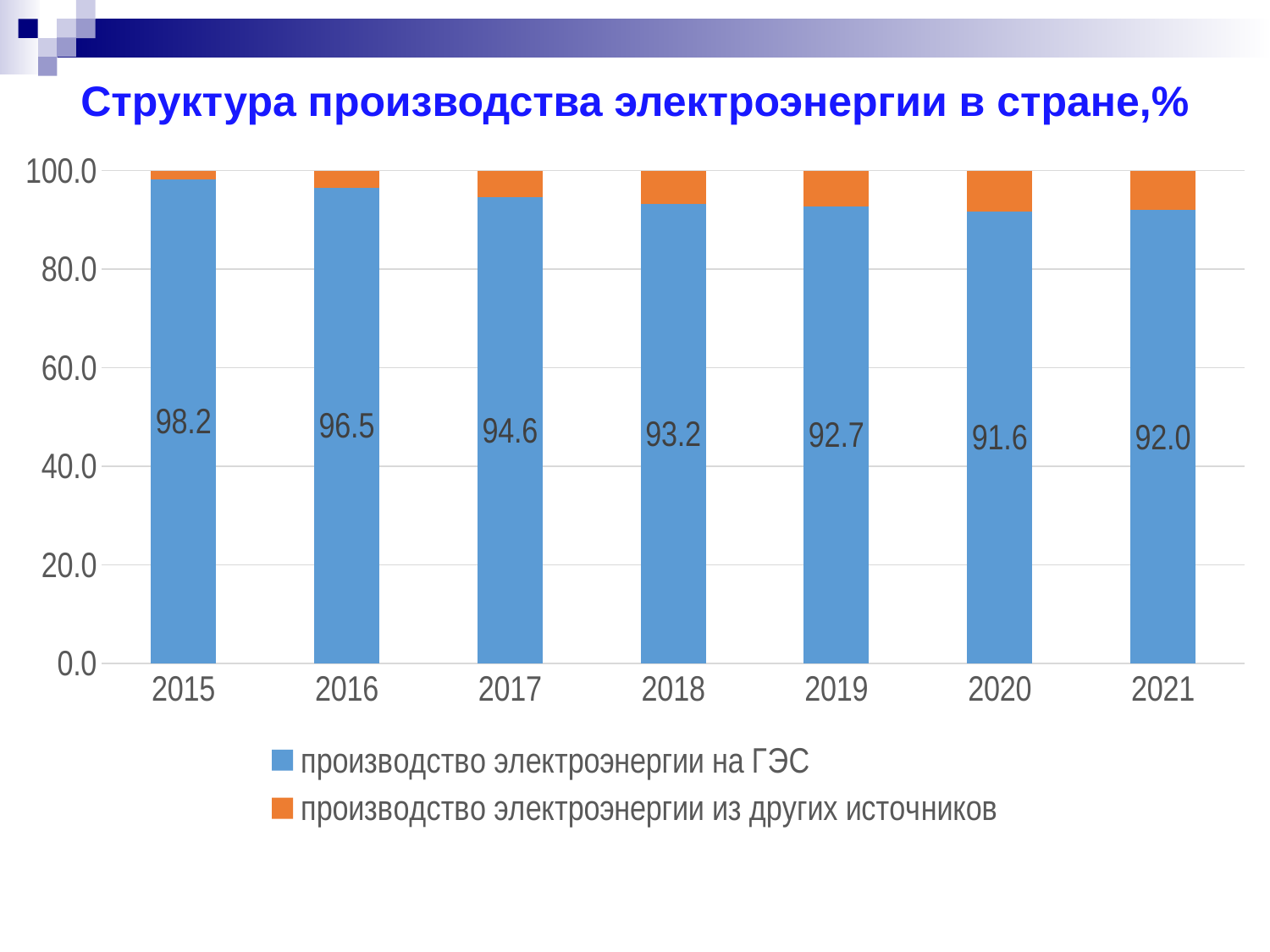
How many series does the legend list? 2 Does the share of производство электроэнергии на ГЭС generally rise or fall from 2015 to 2021? fall What is the value for производство электроэнергии на ГЭС in 2021? 92.0 Which year has a larger ГЭС share, 2016 or 2019? 2016 Is the value for производство электроэнергии из других источников in 2021 greater or less than 20.0? less What is the value for производство электроэнергии на ГЭС in 2018? 93.2 What is the value for производство электроэнергии на ГЭС in 2015? 98.2 How many years are shown on the x axis? 7 What kind of chart is shown on the slide? stacked bar chart In which year is the share of производство электроэнергии на ГЭС the highest? 2015 In which year is the share of производство электроэнергии на ГЭС the lowest? 2020 What is the difference between the ГЭС share in 2015 and in 2020? 6.6